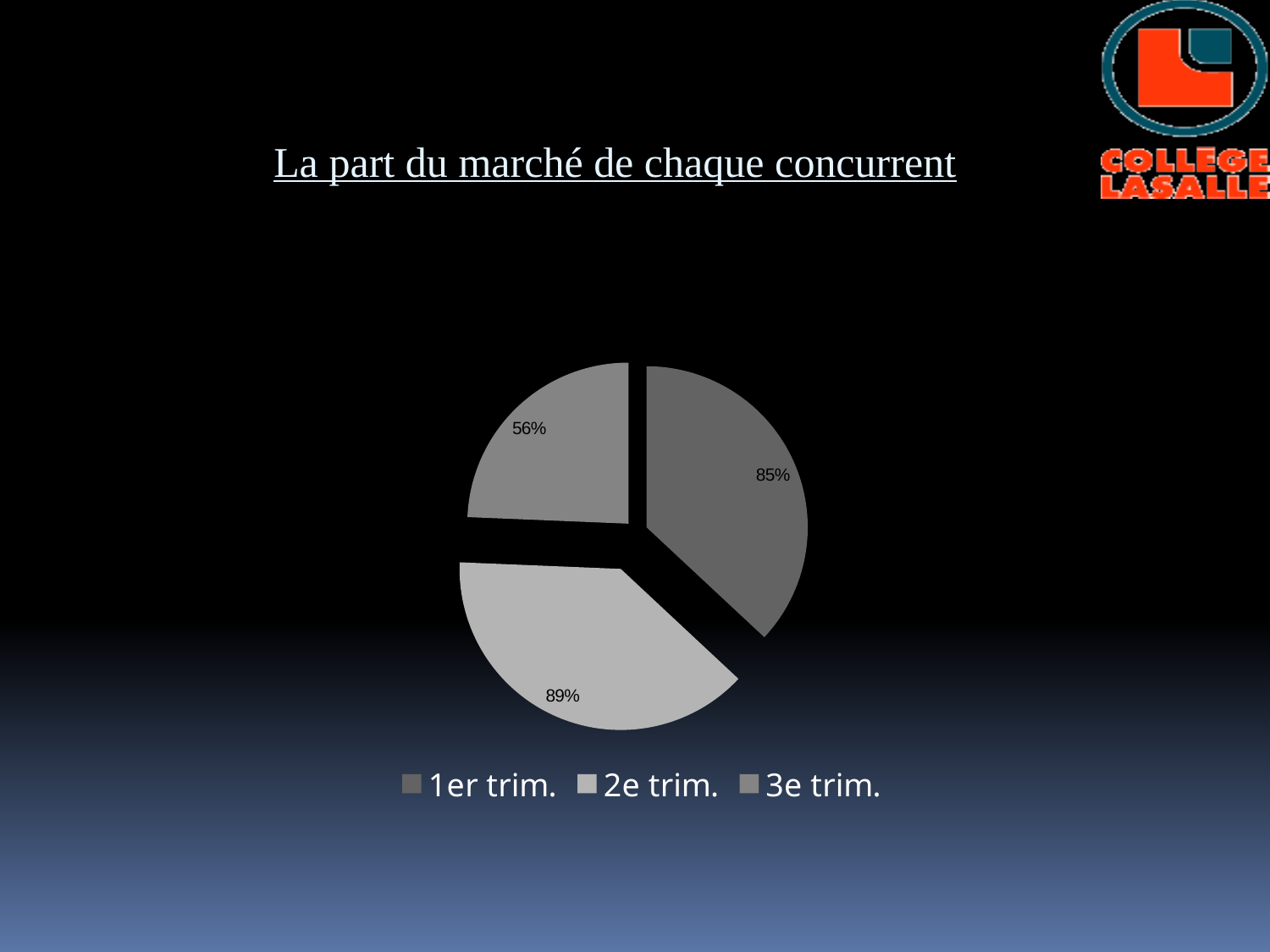
What is the title of the chart on the slide? La part du marché de chaque concurrent What type of chart is shown on the slide? pie chart Which slice has the smallest labelled value? 3e trim. What is the difference between the labelled values for 2e trim. and 3e trim.? 33% What value is labelled on the slice for 1er trim.? 85% What value is labelled on the slice for 2e trim.? 89% Which slice has the largest labelled value? 2e trim. Which is larger, the labelled value for 1er trim. or for 3e trim.? 1er trim. What value is labelled on the slice for 3e trim.? 56% What are the three legend entries of the pie chart? 1er trim., 2e trim., 3e trim. How many slices does the pie chart have? 3 How many entries does the legend list? 3